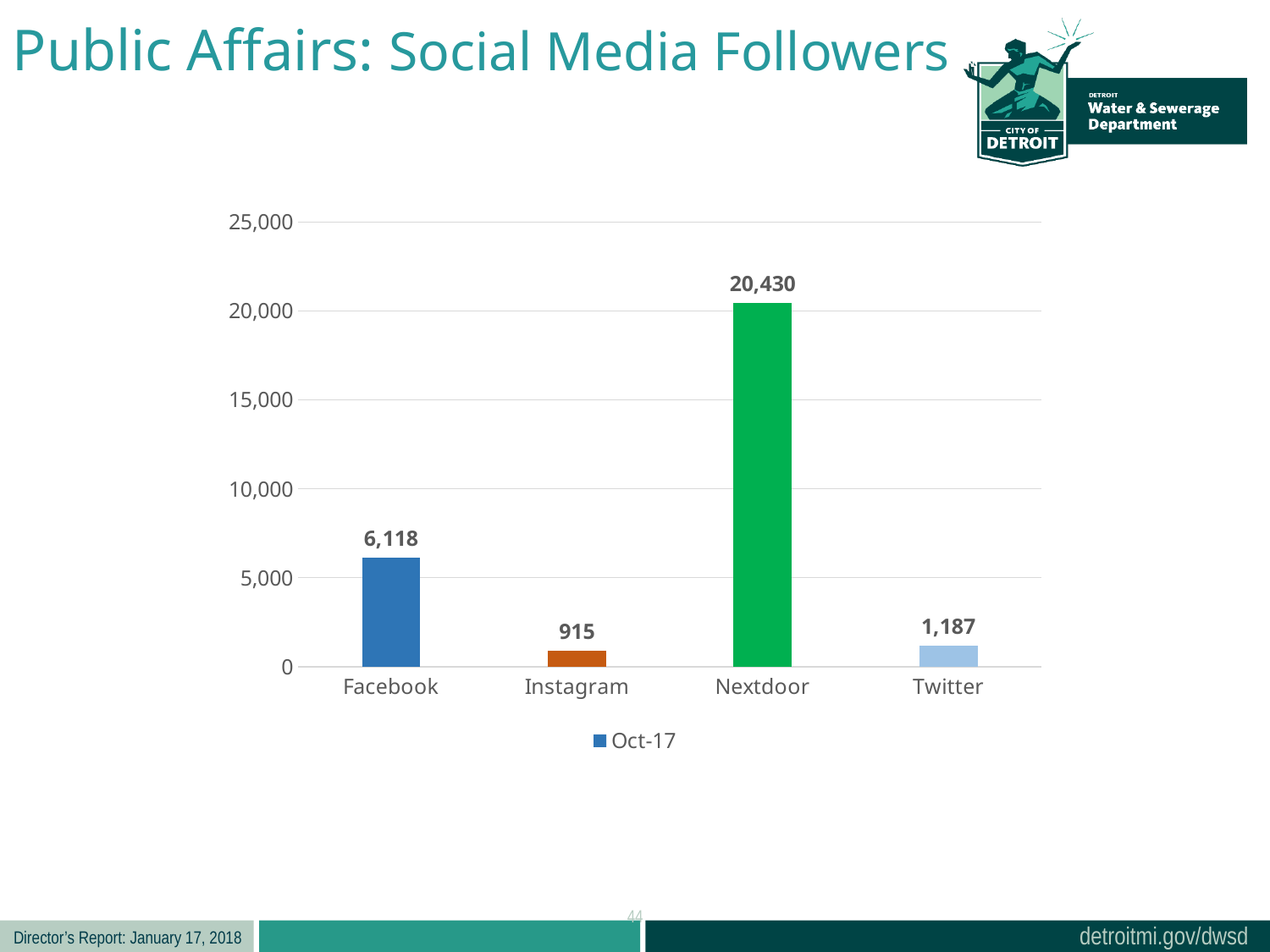
What series does the legend list? Oct-17 How many followers does Nextdoor have? 20,430 What is the value for Facebook? 6,118 What is the value for Instagram? 915 What is the value for Twitter? 1,187 Which platform has the highest number of followers? Nextdoor How many platforms are shown on the chart? 4 What is the difference between the Twitter and Instagram values? 272 Which has more followers, Facebook or Twitter? Facebook Which platform has the lowest number of followers? Instagram What kind of chart is shown on the slide? Bar chart What is the difference between the Nextdoor and Facebook values? 14,312